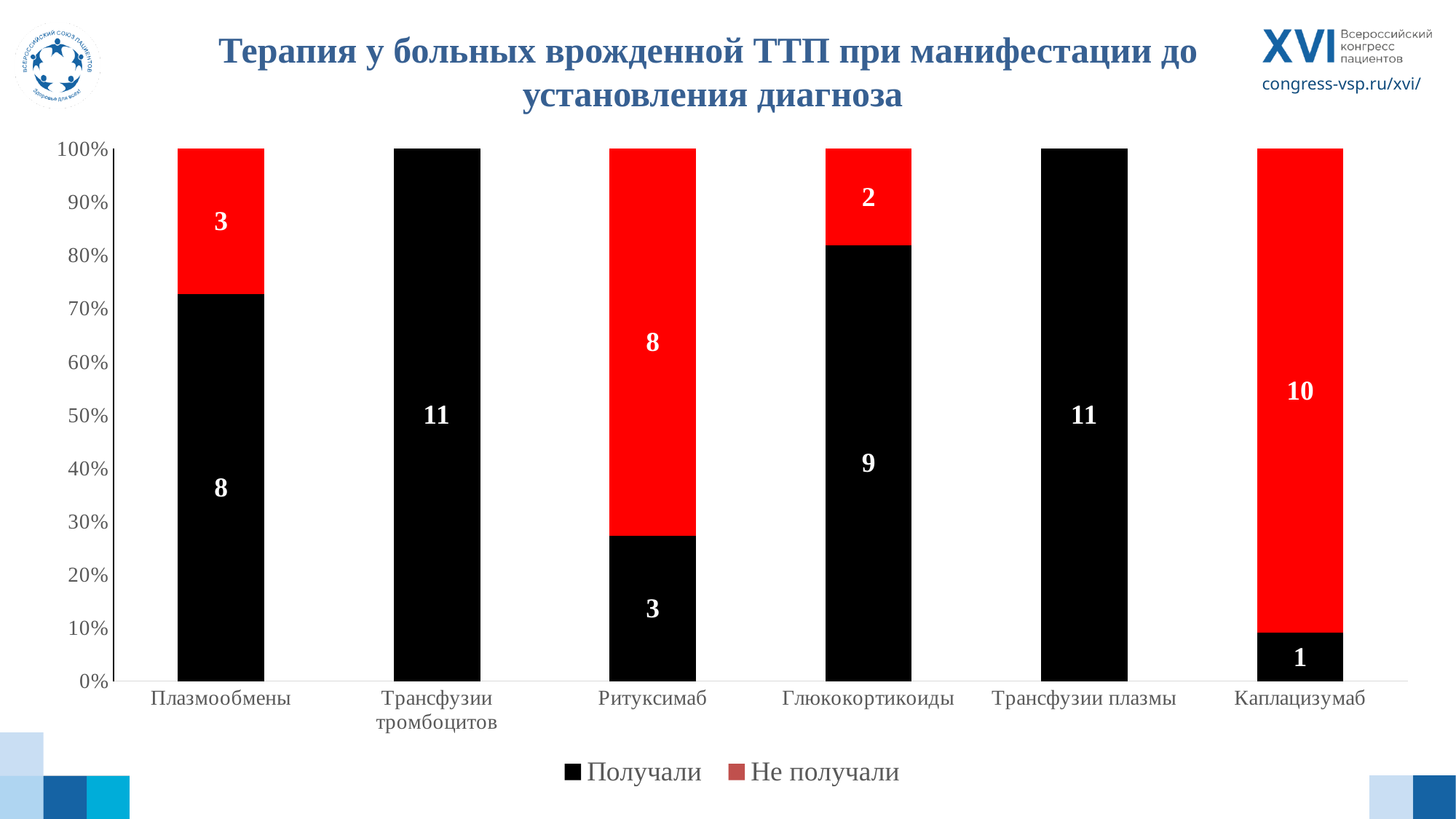
How many patients received (Получали) Плазмообмены? 8 How many patients did not receive (Не получали) Ритуксимаб? 8 What is the total of the Плазмообмены stacked bar (Получали plus Не получали)? 11 What is the value for Получали in the Каплацизумаб bar? 1 Is the Получали share of the Плазмообмены bar greater or less than 70%? greater Which category has the highest value for Не получали? Каплацизумаб What is the value for Не получали in the Глюкокортикоиды bar? 2 Which is larger: the Получали value for Плазмообмены or the Получали value for Ритуксимаб? Плазмообмены How many series does the legend list? 2 How many categories are shown on the x axis? 6 What is the difference between the Получали values for Глюкокортикоиды and Ритуксимаб? 6 Which category has the lowest value for Получали? Каплацизумаб